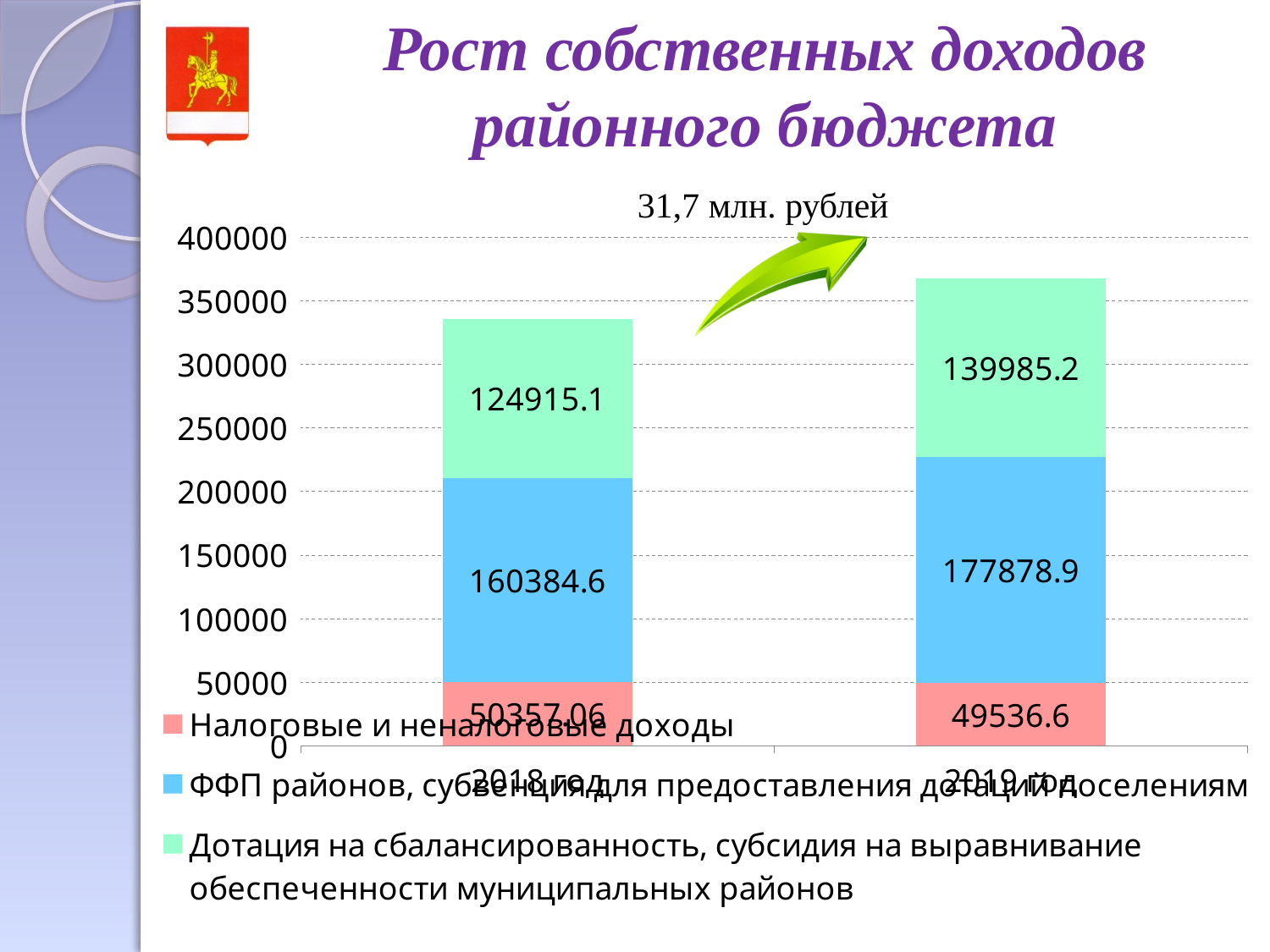
What is the difference between the 'ФФП районов' values for 2019 год and 2018 год? 17494.3 What is the value of 'Налоговые и неналоговые доходы' for 2019 год? 49536.6 By how much did 'Дотация на сбалансированность, субсидия на выравнивание обеспеченности муниципальных районов' change from 2018 год to 2019 год? 15070.1 How many series does the legend list? 3 Which year has the larger value for 'ФФП районов, субвенция для предоставления дотаций поселениям'? 2019 год What is the total of the stacked bar for 2019 год? 367400.7 What is the value of 'Дотация на сбалансированность, субсидия на выравнивание обеспеченности муниципальных районов' for 2019 год? 139985.2 Is the total of the stacked bar for 2018 год greater or less than 350000? less What is the value of 'ФФП районов, субвенция для предоставления дотаций поселениям' for 2019 год? 177878.9 How many categories (years) are shown on the x axis? 2 What is the value of 'ФФП районов, субвенция для предоставления дотаций поселениям' for 2018 год? 160384.6 What type of chart is shown on the slide? stacked bar chart